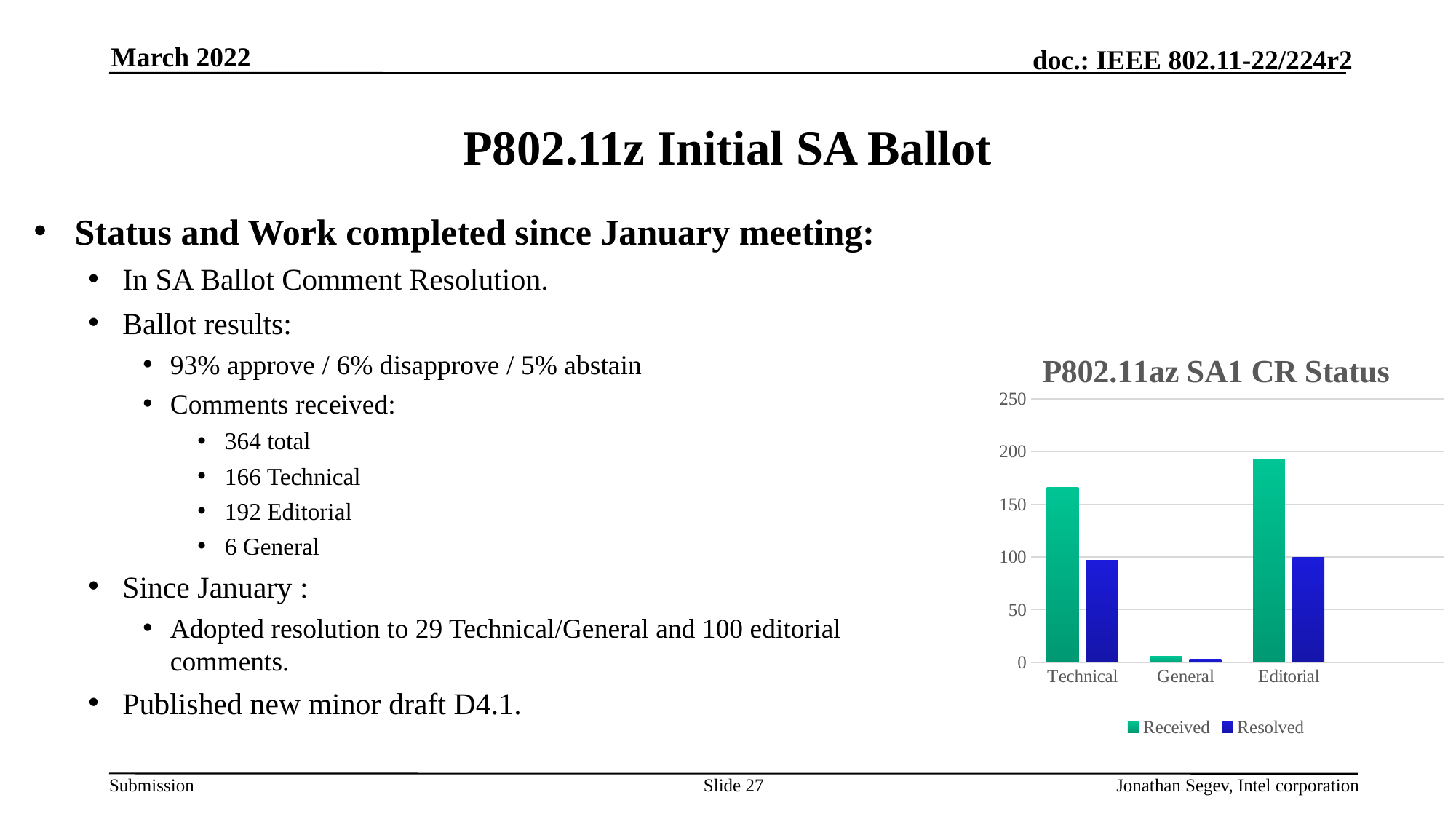
Is the Resolved value for Technical greater or less than 50? greater Which category has the lowest Resolved value? General How many series does the chart legend list? 2 What is the title of the chart? P802.11az SA1 CR Status Is the Received value for Technical greater or less than 150? greater Which category has the highest Received value? Editorial What kind of chart is shown on the slide? bar chart Which category has the lowest Received value? General How many categories are shown on the x axis of the chart? 3 For Technical, which is larger: Received or Resolved? Received Which series is shown in dark blue in the chart? Resolved Is the Received value for Editorial greater or less than 200? less